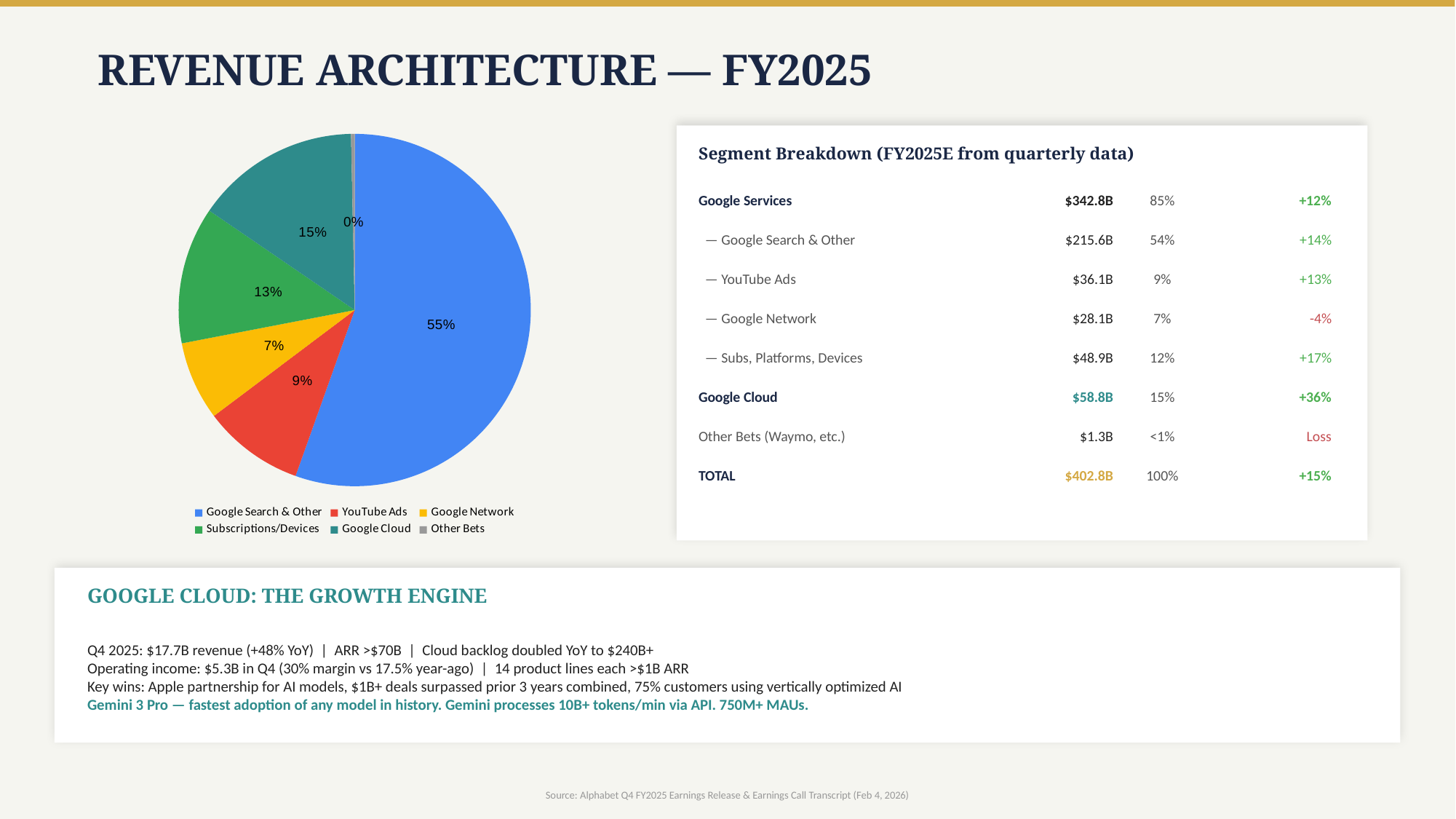
In the pie chart, which is larger: YouTube Ads or Google Network? YouTube Ads What percentage is shown for Google Network in the pie chart? 7% In the pie chart, what is the difference in percentage points between Google Cloud and Subscriptions/Devices? 2 percentage points What share of the pie does Google Search & Other represent? 55% What percentage is shown for YouTube Ads in the pie chart? 9% How many segments does the pie chart legend list? 6 What kind of chart is shown on the left of the slide? Pie chart What percentage is shown for Subscriptions/Devices in the pie chart? 13% Which segment has the largest slice in the pie chart? Google Search & Other What colour is the Google Cloud slice in the pie chart? Teal What percentage is shown for Google Cloud in the pie chart? 15% Which segment has the smallest slice in the pie chart? Other Bets